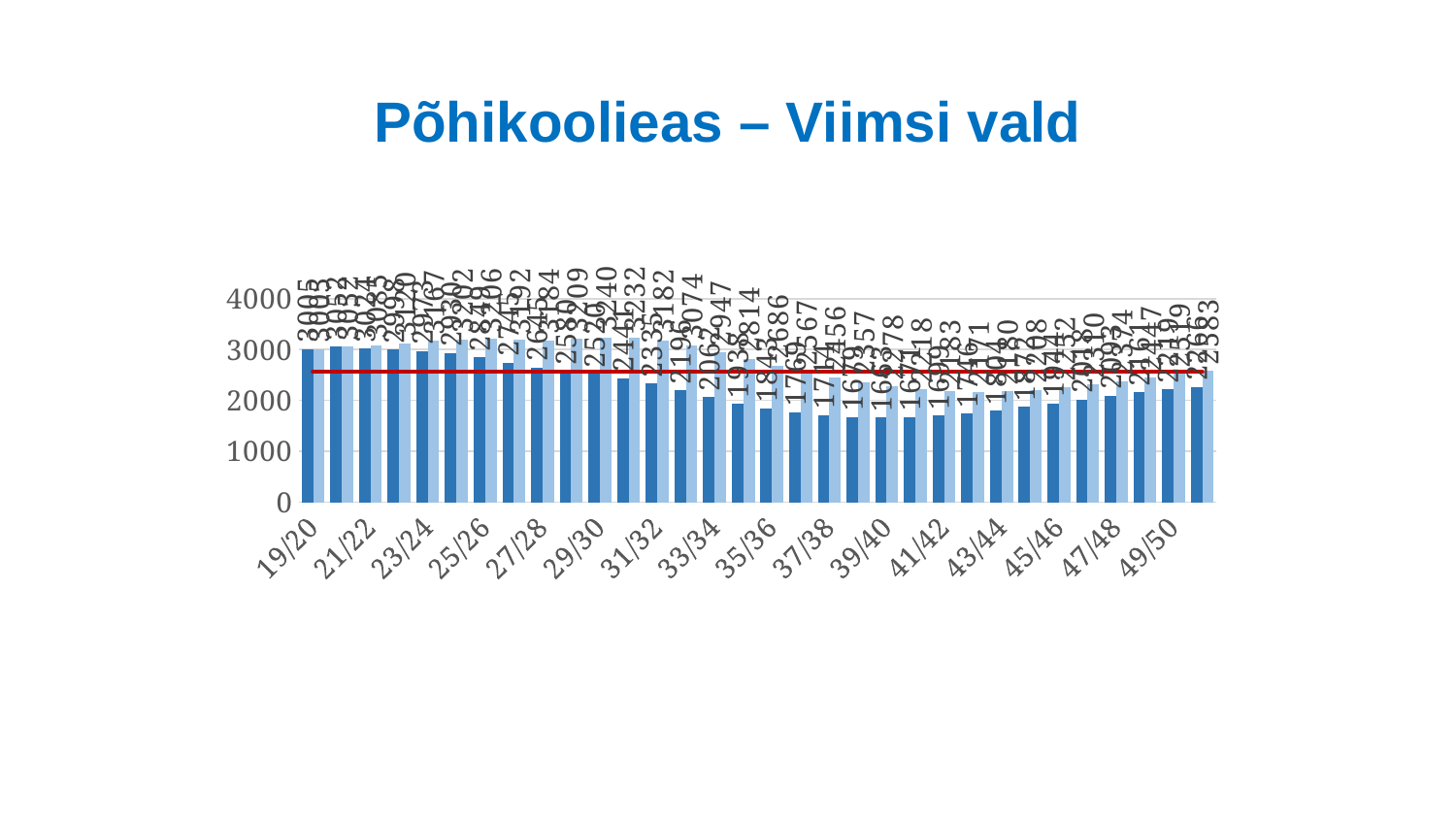
Is the value of the dark blue bar for 41/42 greater or less than 2000? less Is the value of the dark blue bar for 29/30 greater or less than 2000? greater Which has the larger dark blue bar, 19/20 or 39/40? 19/20 What is the title of the chart? Põhikoolieas – Viimsi vald Is the value of the dark blue bar for 39/40 greater or less than 2000? less What kind of chart is shown on the slide? combination bar and line chart Do the bar values generally rise or fall from 41/42 to 49/50? rise What is the highest value shown on the vertical axis? 4000 Which has the larger dark blue bar, 21/22 or 41/42? 21/22 Do the bar values generally rise or fall from 19/20 to 39/40? fall